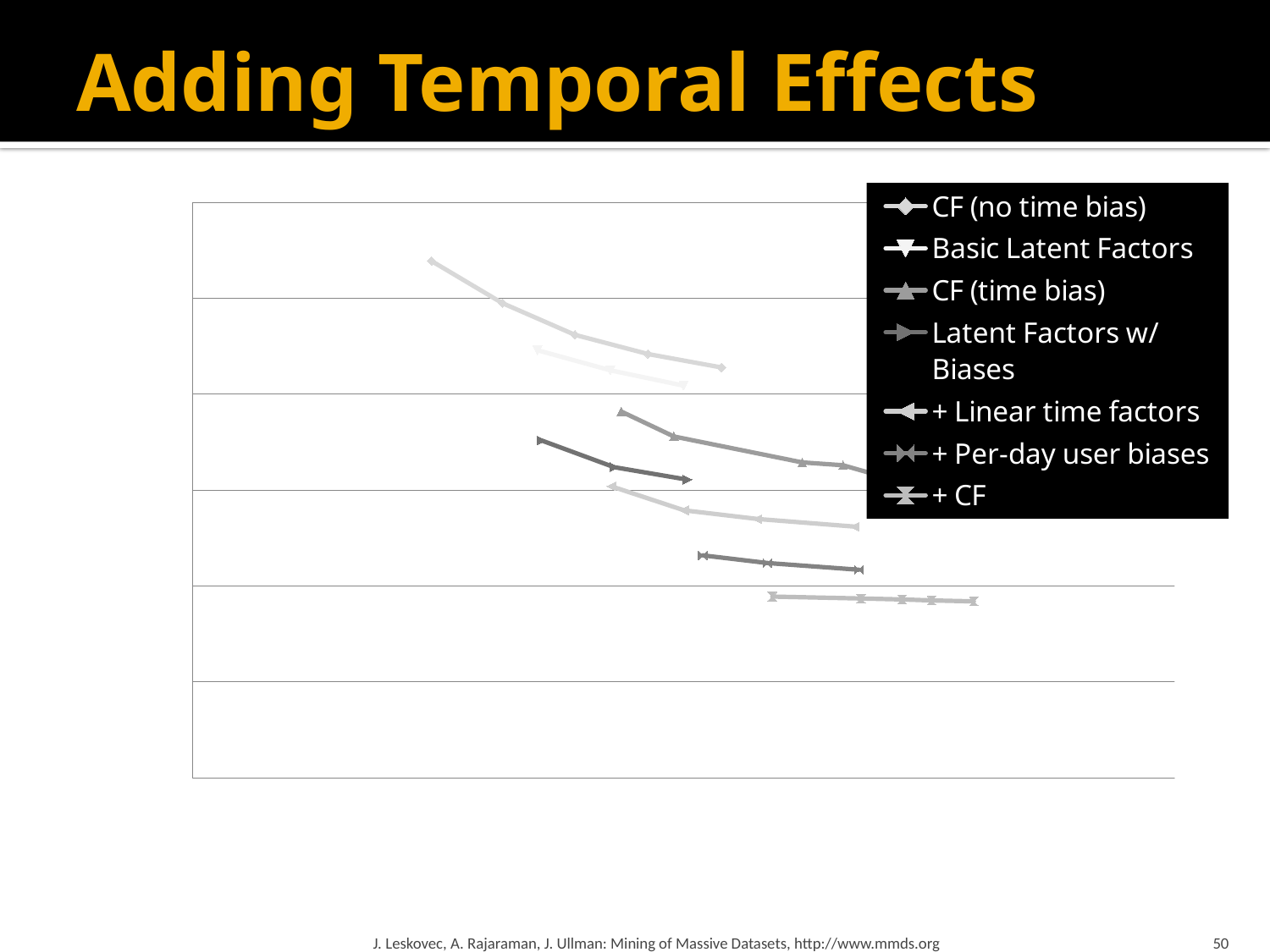
What kind of chart is shown on the slide? line chart Do the plotted lines rise or fall from left to right along the x axis? fall How many data points does the topmost line in the chart have? 5 What is the title of the slide containing the chart? Adding Temporal Effects What is the first entry listed in the chart's legend? CF (no time bias) How many series does the chart's legend list? 7